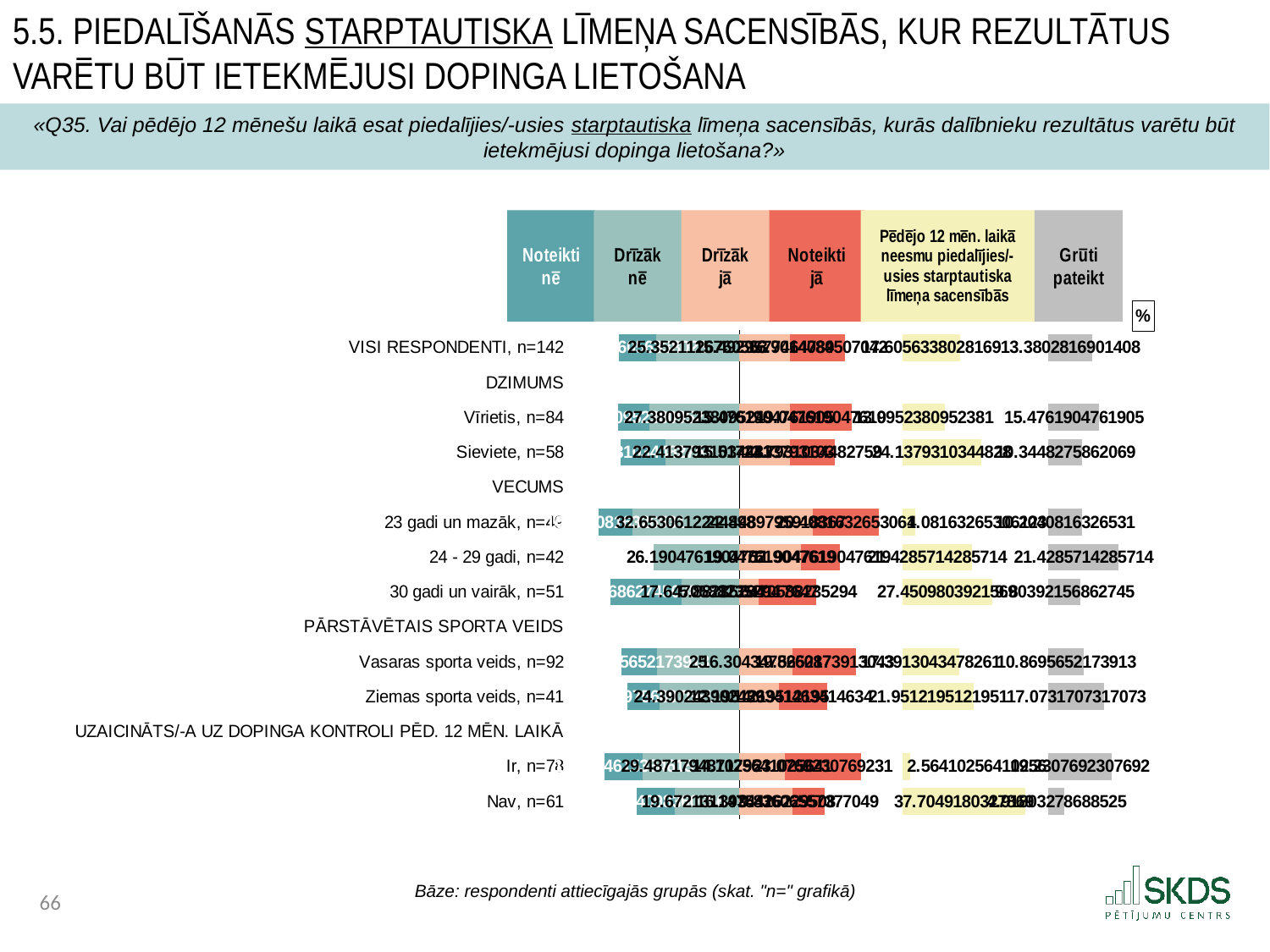
What is the sample size (n) for the group 'Vasaras sporta veids'? 92 What kind of chart is shown on the slide? stacked bar chart What is the sample size (n) for the group 'Vīrietis'? 84 What is the sample size (n) for the group 'Sieviete'? 58 How many respondent groups (bars) are plotted in the chart? 10 Which group has a larger sample size, 'Vasaras sporta veids' or 'Ziemas sporta veids'? Vasaras sporta veids What is the sample size (n) for the group 'Ziemas sporta veids'? 41 How many series does the chart legend list? 6 What is the first series listed in the chart legend? Noteikti nē What is the sample size (n) for the group 'VISI RESPONDENTI'? 142 What is the last series listed in the chart legend? Grūti pateikt What is the sample size (n) for the group 'Nav'? 61